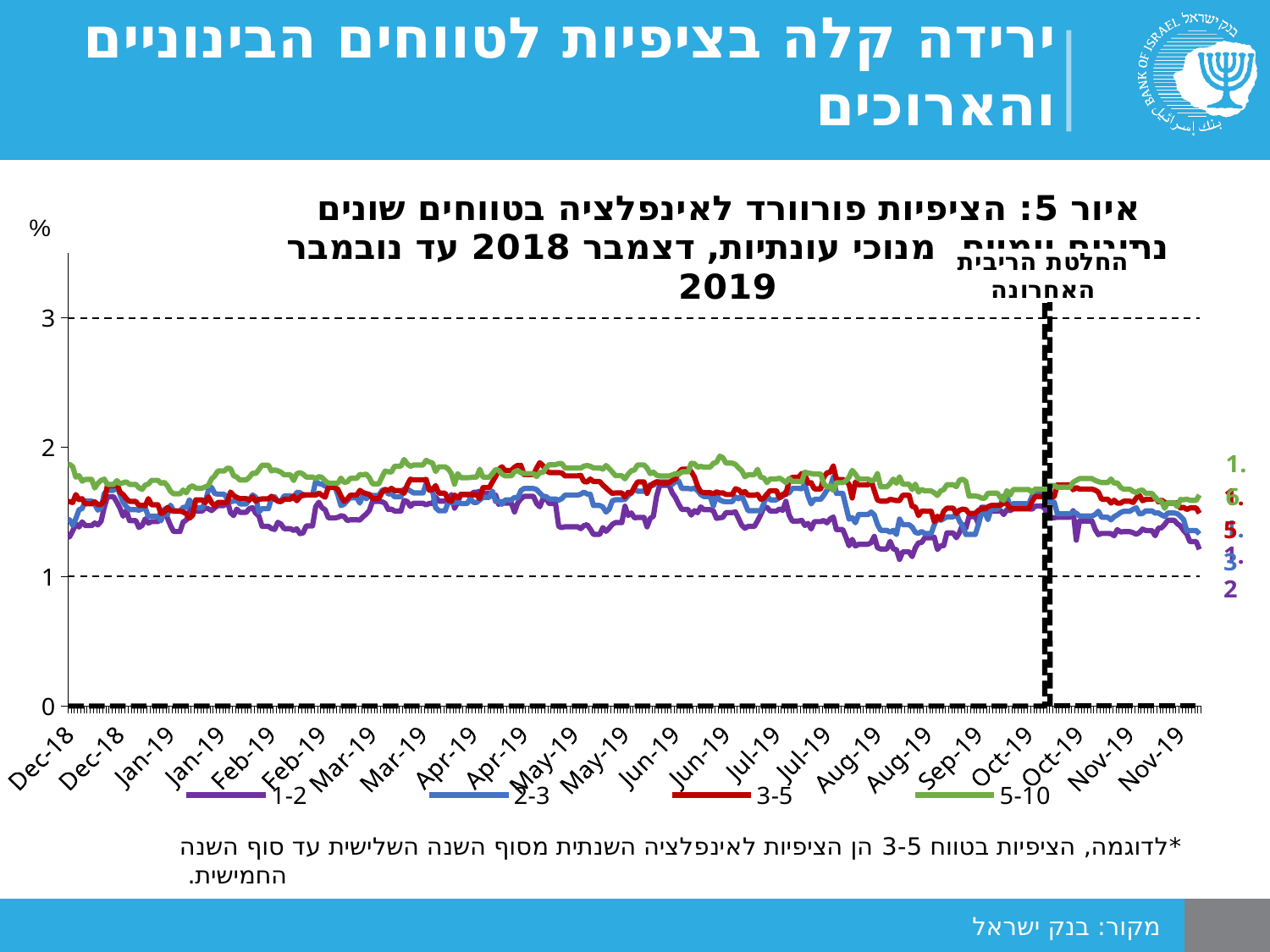
Is the value of the 1-2 series at Nov-19 greater or less than 1? greater How many series does the legend list? 4 Is the value of the 5-10 series at Nov-19 greater or less than 2? less What colour is the line for the 5-10 series? green Is the value of the 5-10 series at Dec-18 greater or less than 1? greater What are the four series listed in the legend? 1-2, 2-3, 3-5, 5-10 At the end of the period (Nov-19), which is larger: the 5-10 series or the 1-2 series? 5-10 Which series has the lowest value at the end of the period (Nov-19)? 1-2 What unit is shown on the y axis? % Which series has the highest value at the end of the period (Nov-19)? 5-10 Does the 1-2 series rise or fall between Jun-19 and Aug-19? fall What kind of chart is shown on the slide? line chart